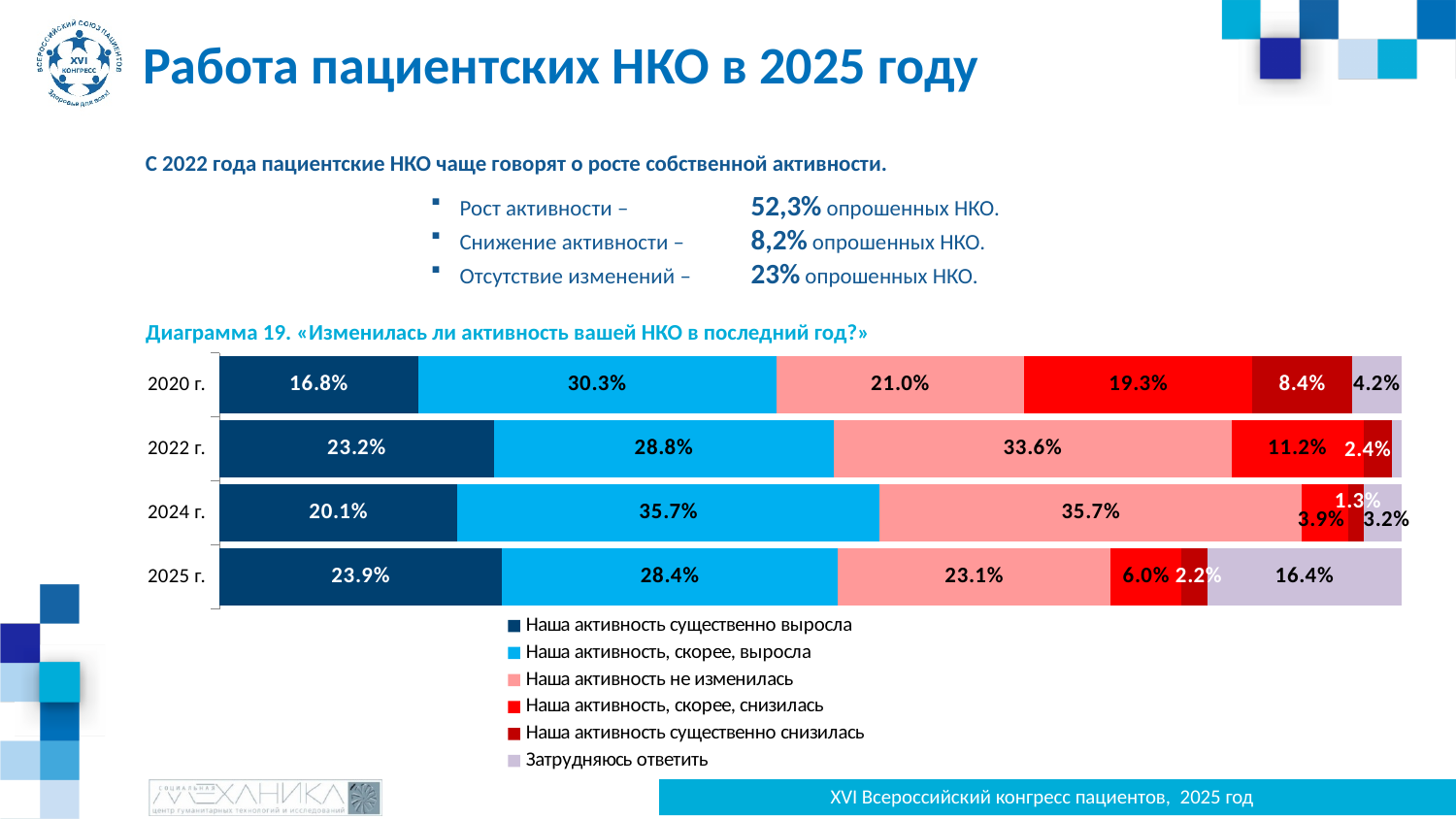
How many years (categories) are shown in the chart? 4 What is the value for «Затрудняюсь ответить» in 2025 г.? 16.4% What is the value for «Наша активность существенно выросла» in 2025 г.? 23.9% What is the value for «Наша активность не изменилась» in 2022 г.? 33.6% What is the value for «Наша активность, скорее, выросла» in 2020 г.? 30.3% What is the title of the chart (Диаграмма 19)? «Изменилась ли активность вашей НКО в последний год?» In which year is the share of «Наша активность не изменилась» the highest? 2024 г. Which year has the larger value for «Наша активность, скорее, снизилась»: 2020 г. or 2025 г.? 2020 г. In which year is the share of «Наша активность существенно снизилась» the lowest? 2024 г. How many series does the chart legend list? 6 What kind of chart is shown on the slide? Stacked bar chart By how many percentage points does «Наша активность существенно выросла» in 2025 г. exceed the value in 2020 г.? 7.1 percentage points